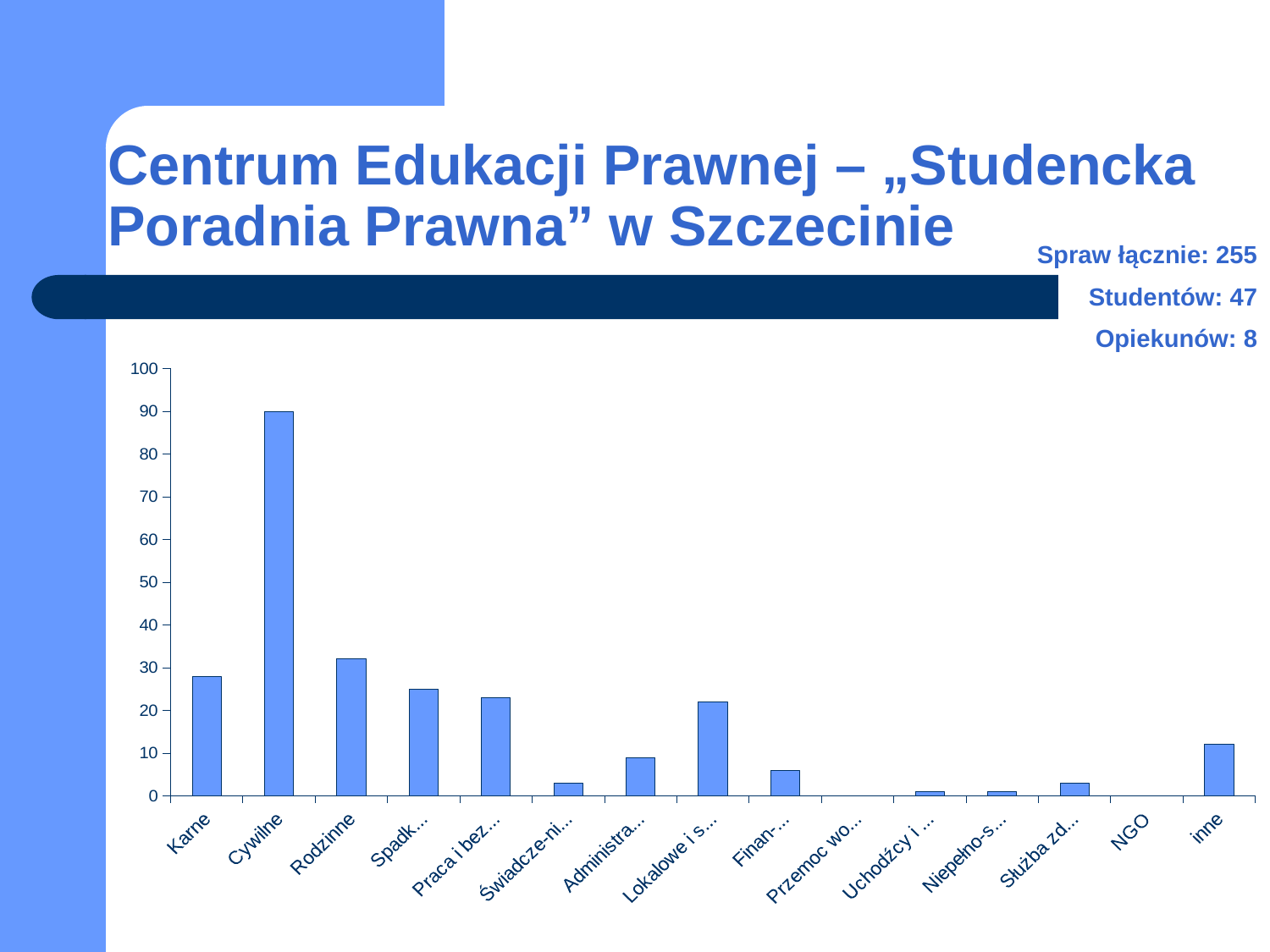
Is the value for Rodzinne greater or less than 20? greater What type of chart is shown on the slide? bar chart Which is larger, the value for Cywilne or the value for Rodzinne? Cywilne What is the highest value shown on the vertical axis of the chart? 100 Which is larger, the value for inne or the value for NGO? inne Is the value for inne greater or less than 20? less How many categories are shown on the x axis of the chart? 15 What is the value for NGO? 0 What is the value for Cywilne? 90 Is the value for Cywilne greater or less than 50? greater Which category has the highest value in the chart? Cywilne